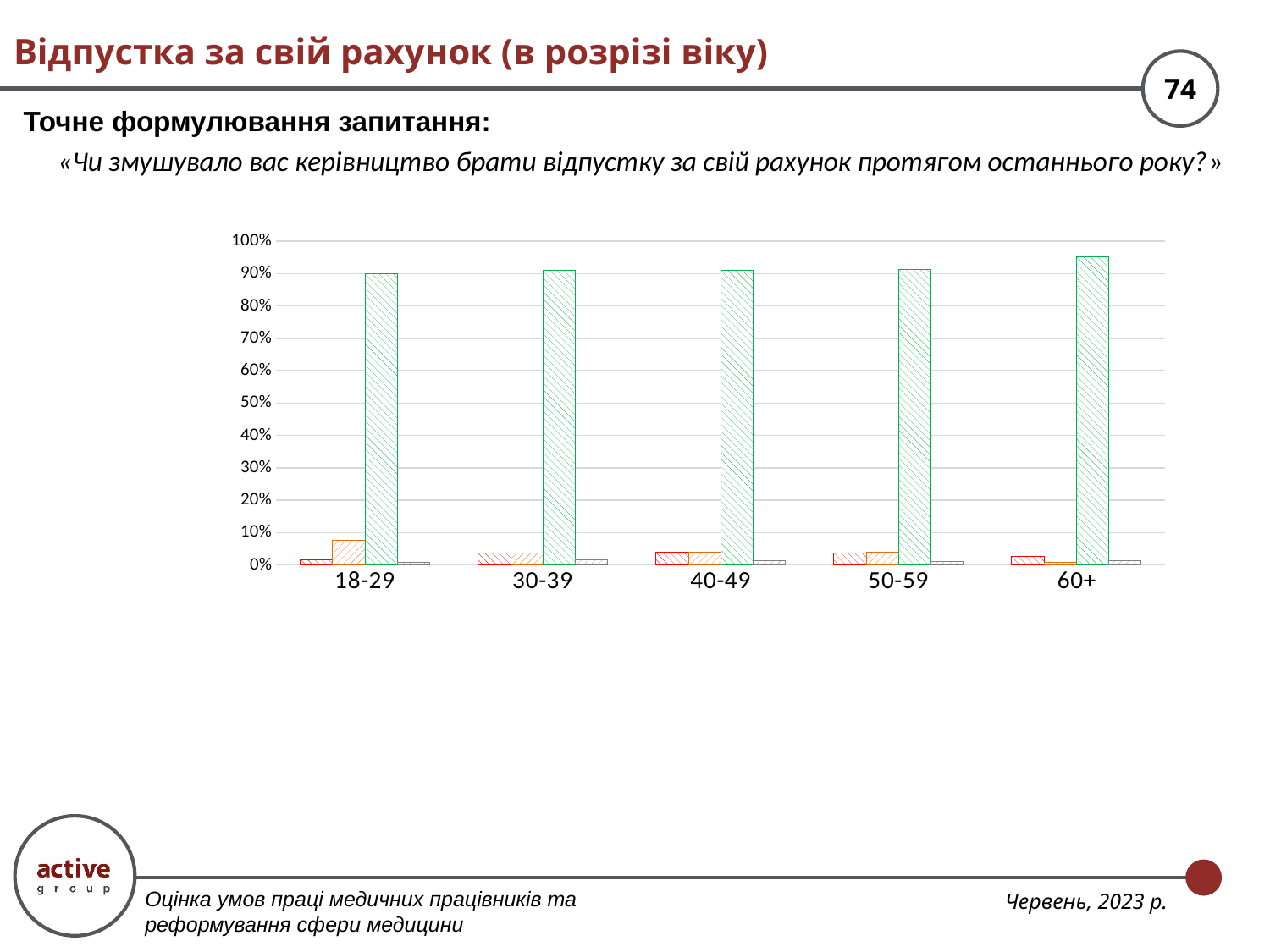
Which is larger: the orange hatched bar for 18-29 or the orange hatched bar for 60+? 18-29 What is the highest value shown on the y axis of the chart? 100% Is the red hatched bar for the 40-49 group greater or less than 10%? less Which is larger in the 50-59 group: the green hatched bar or the red hatched bar? the green hatched bar What kind of chart is shown on the slide? bar chart How many age groups are shown on the x axis of the chart? 5 Is the green hatched bar for the 18-29 group greater or less than 80%? greater Which age group has the tallest green hatched bar? 60+ How many bars are plotted for each age group in the chart? 4 Is the orange hatched bar for the 18-29 group greater or less than 10%? less What is the label of the last age group on the x axis? 60+